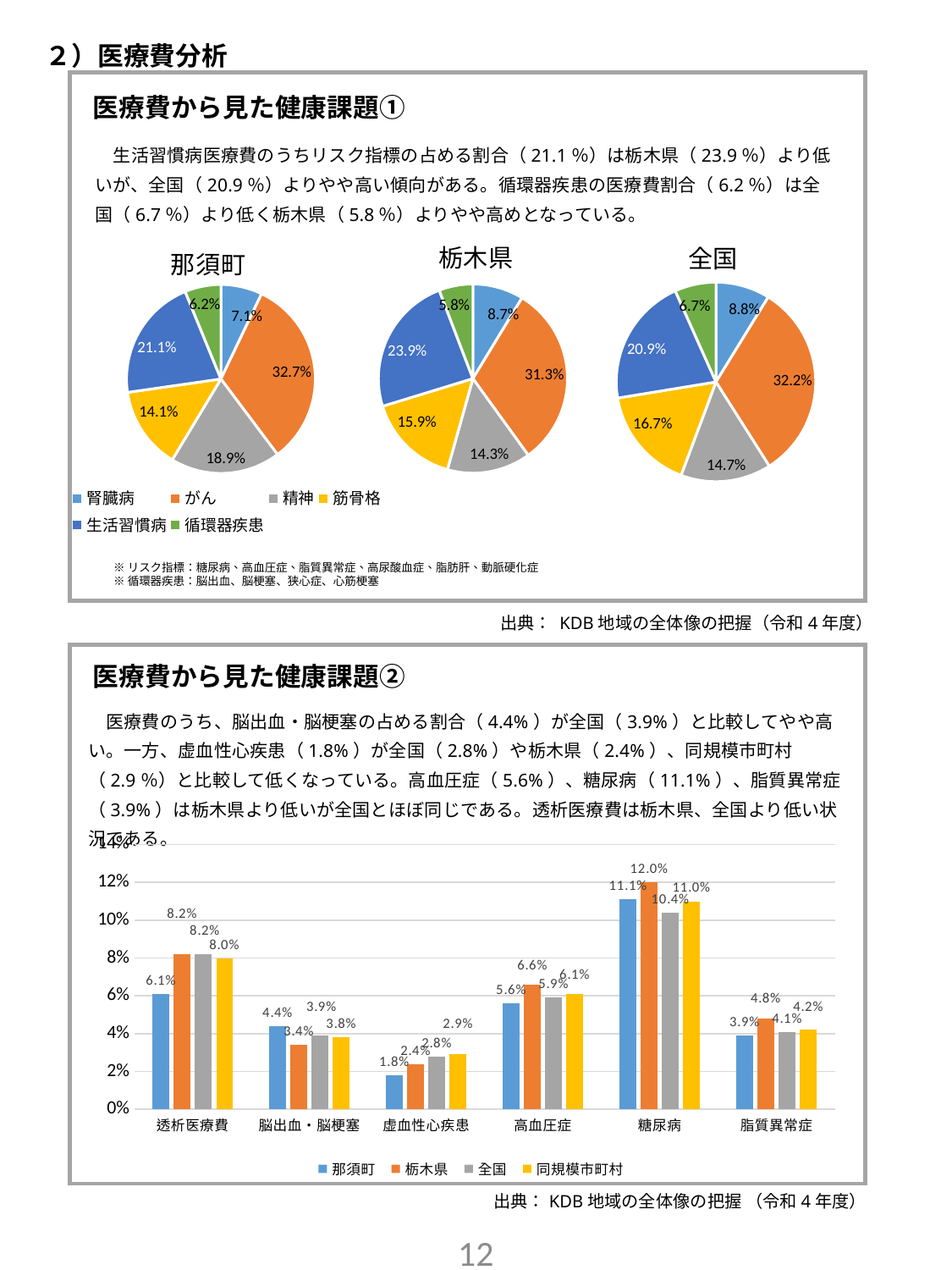
In the bar chart at the bottom, what is the difference between 栃木県 and 那須町 in the 糖尿病 category? 0.9% In the bar chart at the bottom, what is the value for 那須町 in the 糖尿病 category? 11.1% What type of chart is shown at the bottom of the slide? Bar chart In the bar chart at the bottom, which series has the highest value in the 透析医療費 category? 栃木県 and 全国 (both 8.2%) In the 全国 pie chart, which category has the smallest share? 循環器疾患 How many categories are shown on the x axis of the bar chart at the bottom? 6 In the bar chart at the bottom, which is larger in the 脳出血・脳梗塞 category, 那須町 or 全国? 那須町 In the bar chart at the bottom, what is the value for 同規模市町村 in the 虚血性心疾患 category? 2.9% In the 那須町 pie chart, which category has the largest share? がん In the 栃木県 pie chart, what is the value for 生活習慣病? 23.9% In the 那須町 pie chart, what share does がん account for? 32.7% How many series does the legend of the pie charts list? 6